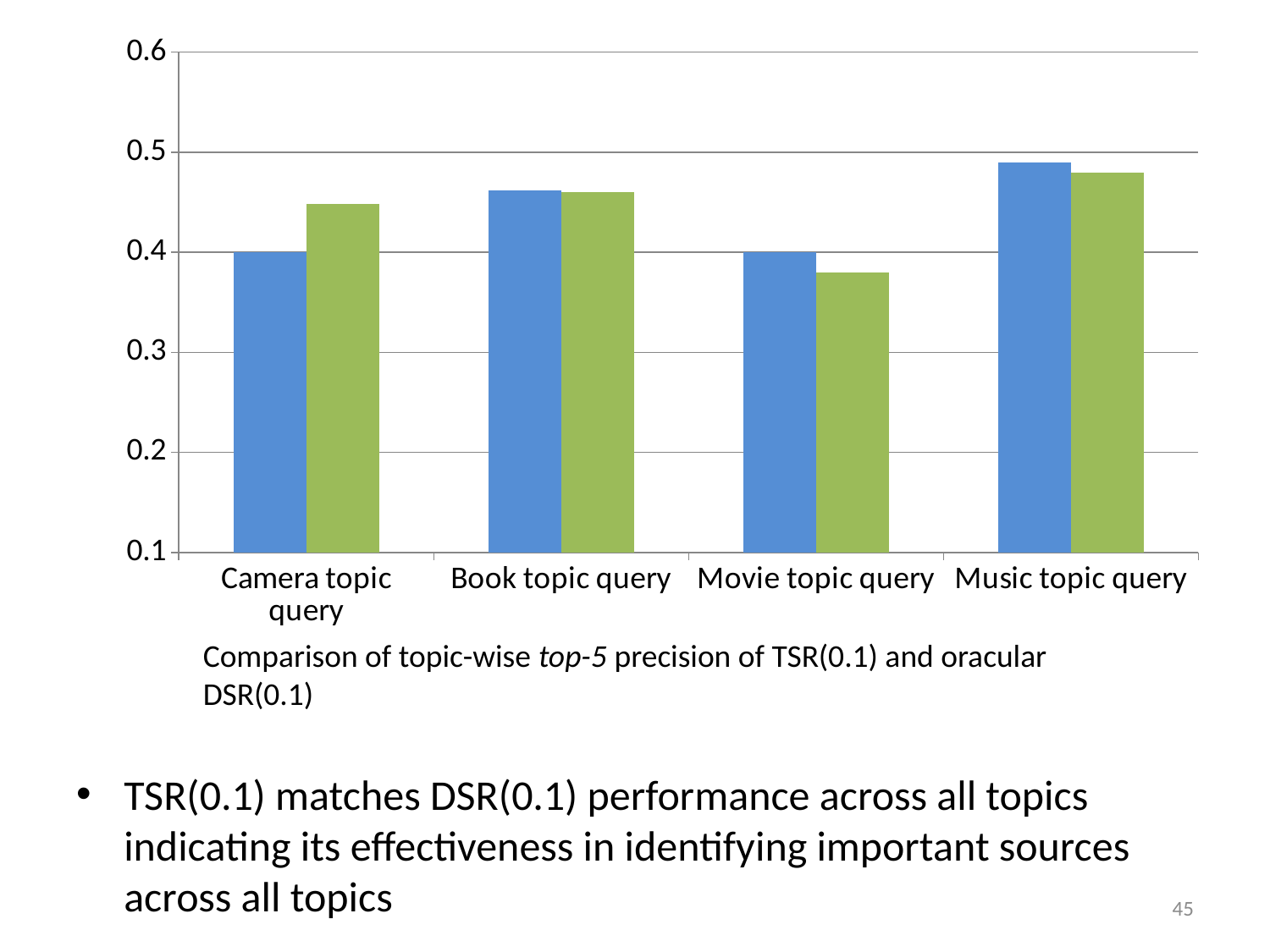
What kind of chart is shown on the slide? bar chart What is the value of the blue bar for Camera topic query? 0.4 Which topic query has the highest blue bar? Music topic query For Movie topic query, which bar is taller, the blue one or the green one? blue How many topic query categories are shown on the x axis? 4 Is the value of the green bar for Movie topic query greater or less than 0.4? less For Camera topic query, which bar is taller, the blue one or the green one? green Is the value of the blue bar for Music topic query greater or less than 0.5? less How many bars are plotted for each topic query category? 2 Is the value of the green bar for Camera topic query greater or less than 0.4? greater Which topic query has the lowest green bar? Movie topic query What is the value of the blue bar for Movie topic query? 0.4